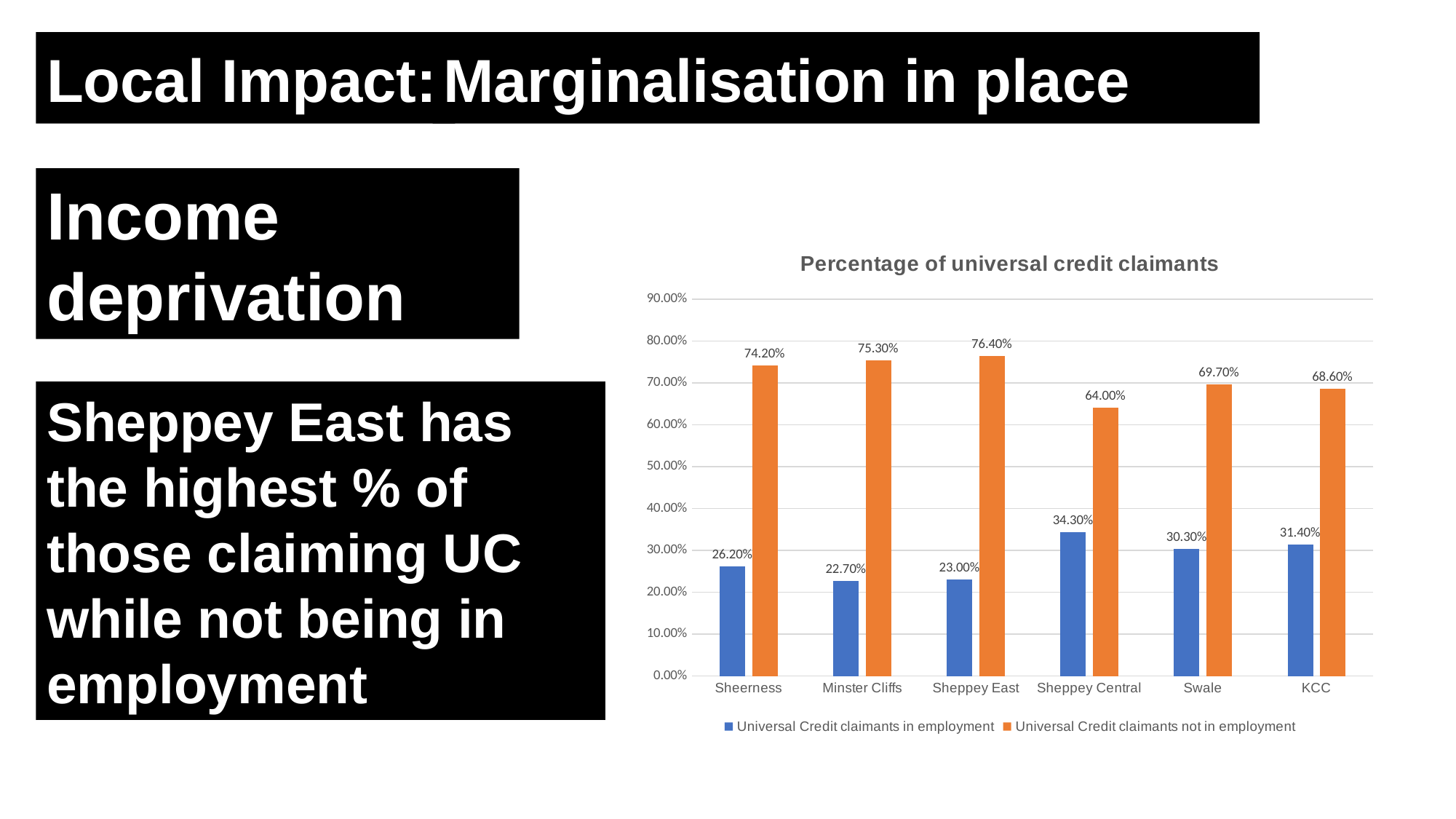
What is the percentage of Universal Credit claimants in employment for Minster Cliffs? 22.70% Which is larger: the percentage of Universal Credit claimants in employment for Swale or for Sheppey Central? Sheppey Central Which area has the highest percentage of Universal Credit claimants not in employment? Sheppey East What is the difference between the percentage of Universal Credit claimants not in employment and in employment for KCC? 37.20% What kind of chart is shown on the slide? Bar chart What is the percentage of Universal Credit claimants not in employment for Sheppey East? 76.40% What is the percentage of Universal Credit claimants in employment for Sheppey Central? 34.30% How many series does the chart legend list? 2 Which area has the lowest percentage of Universal Credit claimants in employment? Minster Cliffs Is the value for Universal Credit claimants not in employment in Sheppey Central greater or less than 70.00%? less What is the title of the chart? Percentage of universal credit claimants How many areas are shown on the x axis of the chart? 6